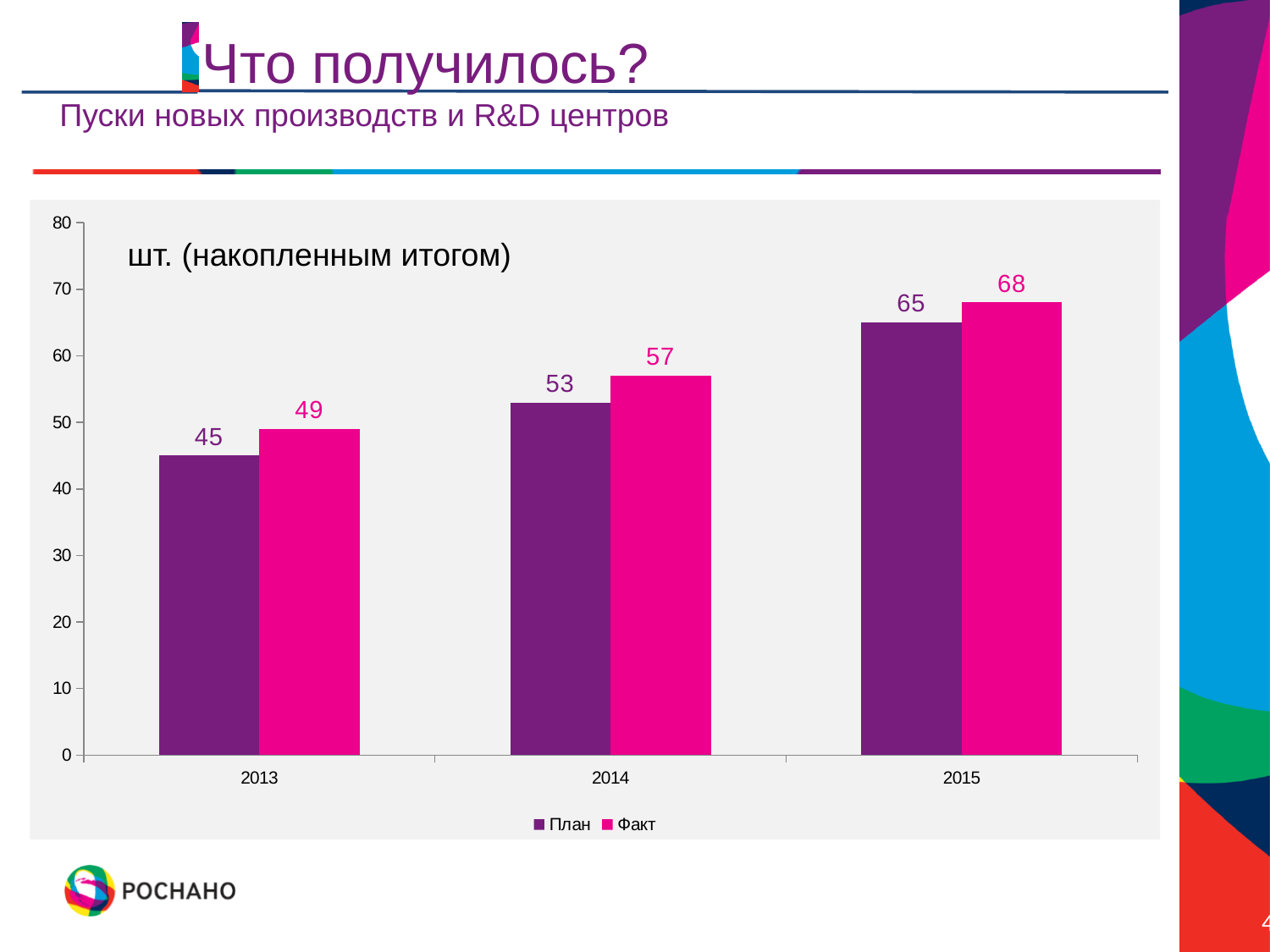
What is the Факт value for 2015? 68 Do the План values rise or fall from 2013 to 2015? rise What is the difference between the Факт values for 2015 and 2013? 19 How many years are shown on the x axis? 3 How many series does the legend list? 2 Which is larger in 2015, the План value or the Факт value? Факт Which year has the highest Факт value? 2015 What is the Факт value for 2014? 57 Which year has the lowest План value? 2013 What is the План value for 2013? 45 What kind of chart is shown on the slide? bar chart What is the difference between the Факт and План values in 2014? 4